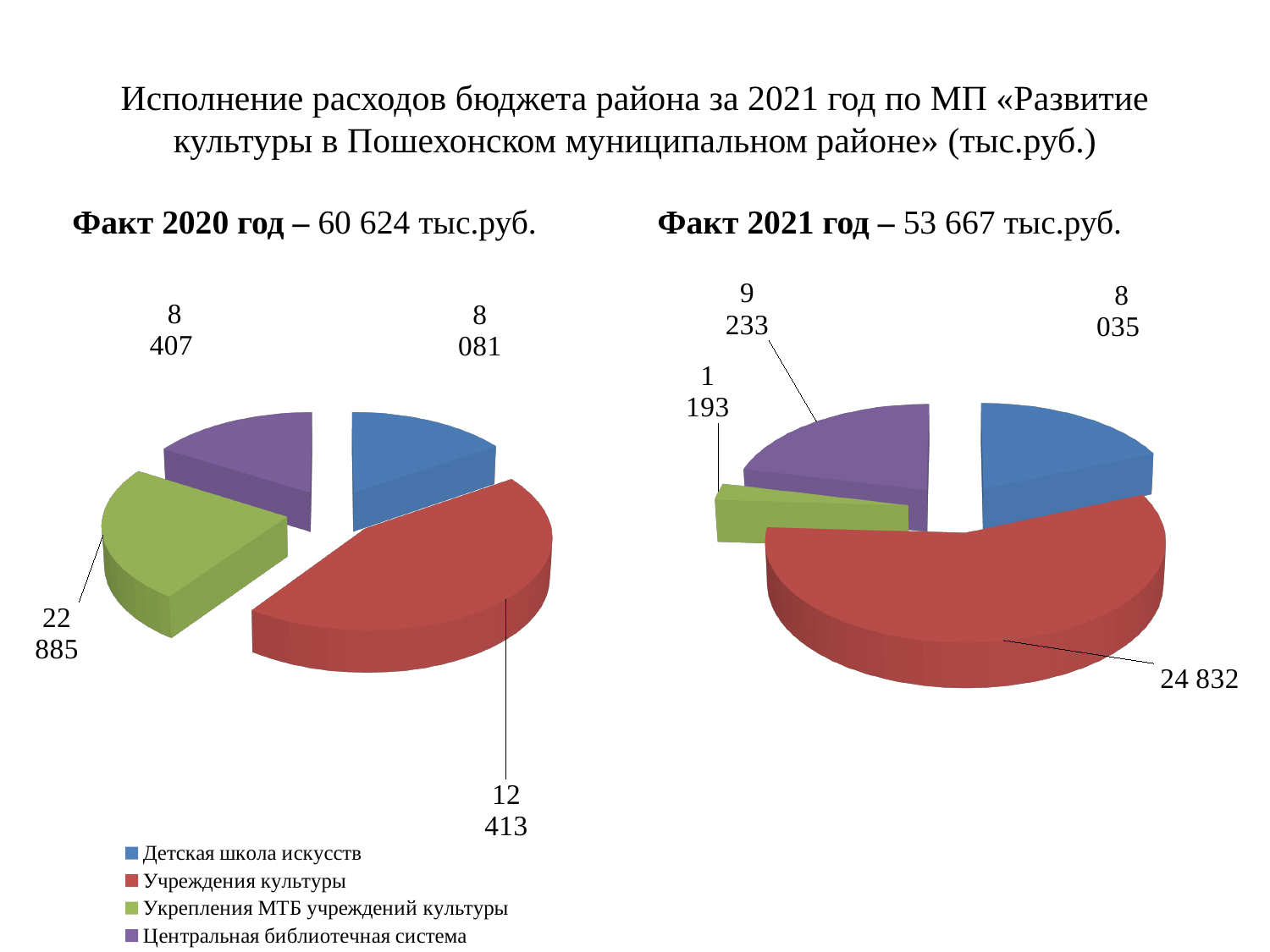
In the 'Факт 2020 год' chart, what is the value for Детская школа искусств? 8 081 In the 'Факт 2021 год' chart, which is larger: Центральная библиотечная система or Детская школа искусств? Центральная библиотечная система How many slices does each pie chart have? 4 In the 'Факт 2021 год' chart, what is the difference between Центральная библиотечная система and Детская школа искусств? 1 198 In the 'Факт 2021 год' chart, what is the value for Укрепления МТБ учреждений культуры? 1 193 In the 'Факт 2021 год' chart, what is the value for Учреждения культуры? 24 832 In the 'Факт 2021 год' chart, which category has the smallest slice? Укрепления МТБ учреждений культуры What kind of chart is used on this slide to show the budget expenditure breakdown? Pie chart In the 'Факт 2021 год' chart, what is the value for Центральная библиотечная система? 9 233 In the 'Факт 2020 год' chart, what is the value for Центральная библиотечная система? 8 407 How many entries does the legend list? 4 In the 'Факт 2021 год' chart, which category has the largest slice? Учреждения культуры